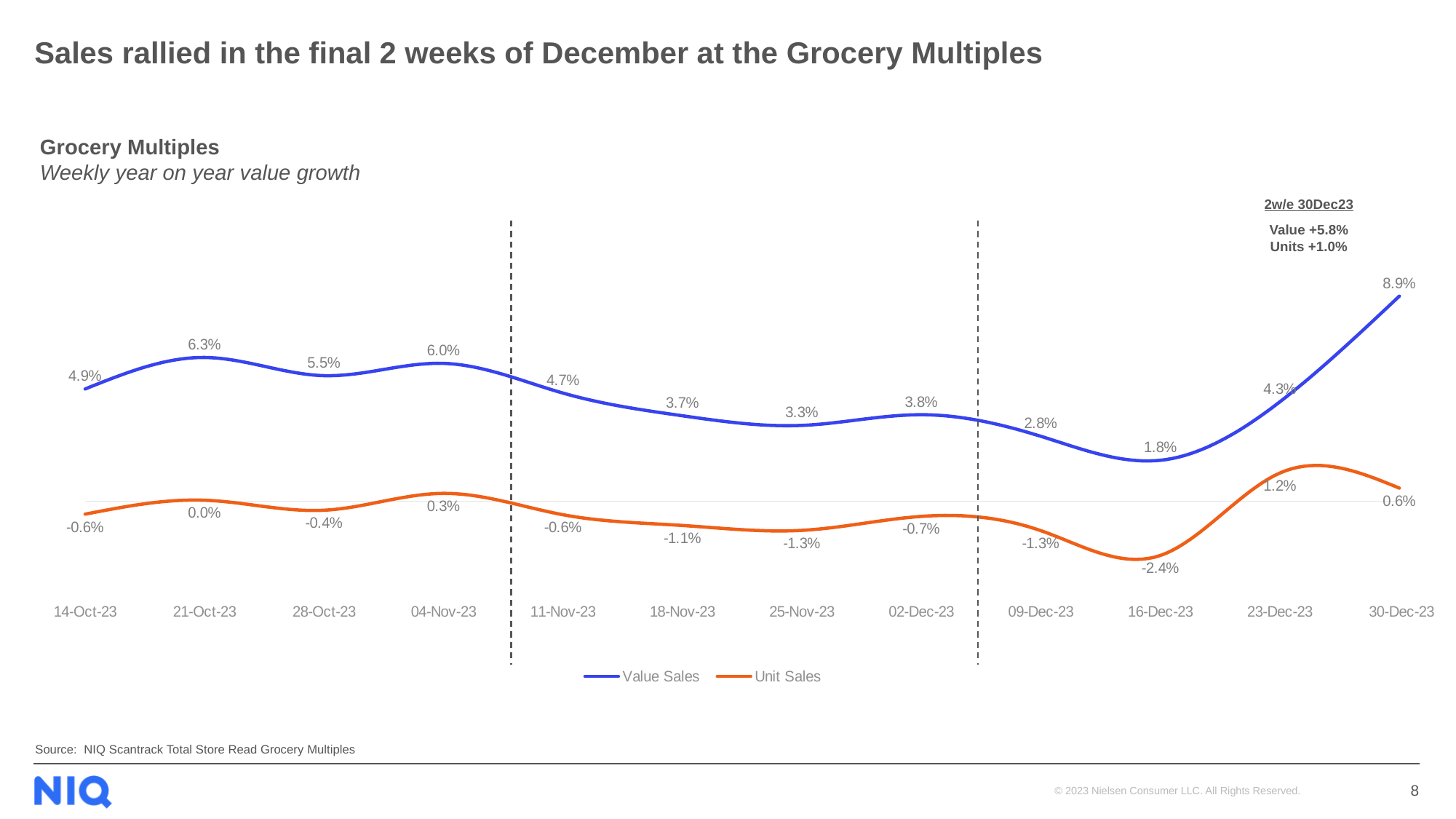
What is the Unit Sales growth for the week of 04-Nov-23? 0.3% How many series does the legend list? 2 What type of chart is shown on the slide? Line chart Which week has the lowest Unit Sales growth? 16-Dec-23 Which week has the lowest Value Sales growth? 16-Dec-23 Which week has the highest Value Sales growth? 30-Dec-23 What is the Value Sales growth for the week of 21-Oct-23? 6.3% What is the Value Sales growth for the week of 30-Dec-23? 8.9% What is the difference between Value Sales growth on 30-Dec-23 and 16-Dec-23? 7.1% What is the Unit Sales growth for the week of 16-Dec-23? -2.4% Is Value Sales growth higher on 21-Oct-23 or on 28-Oct-23? 21-Oct-23 How many weeks are plotted on the x axis? 12